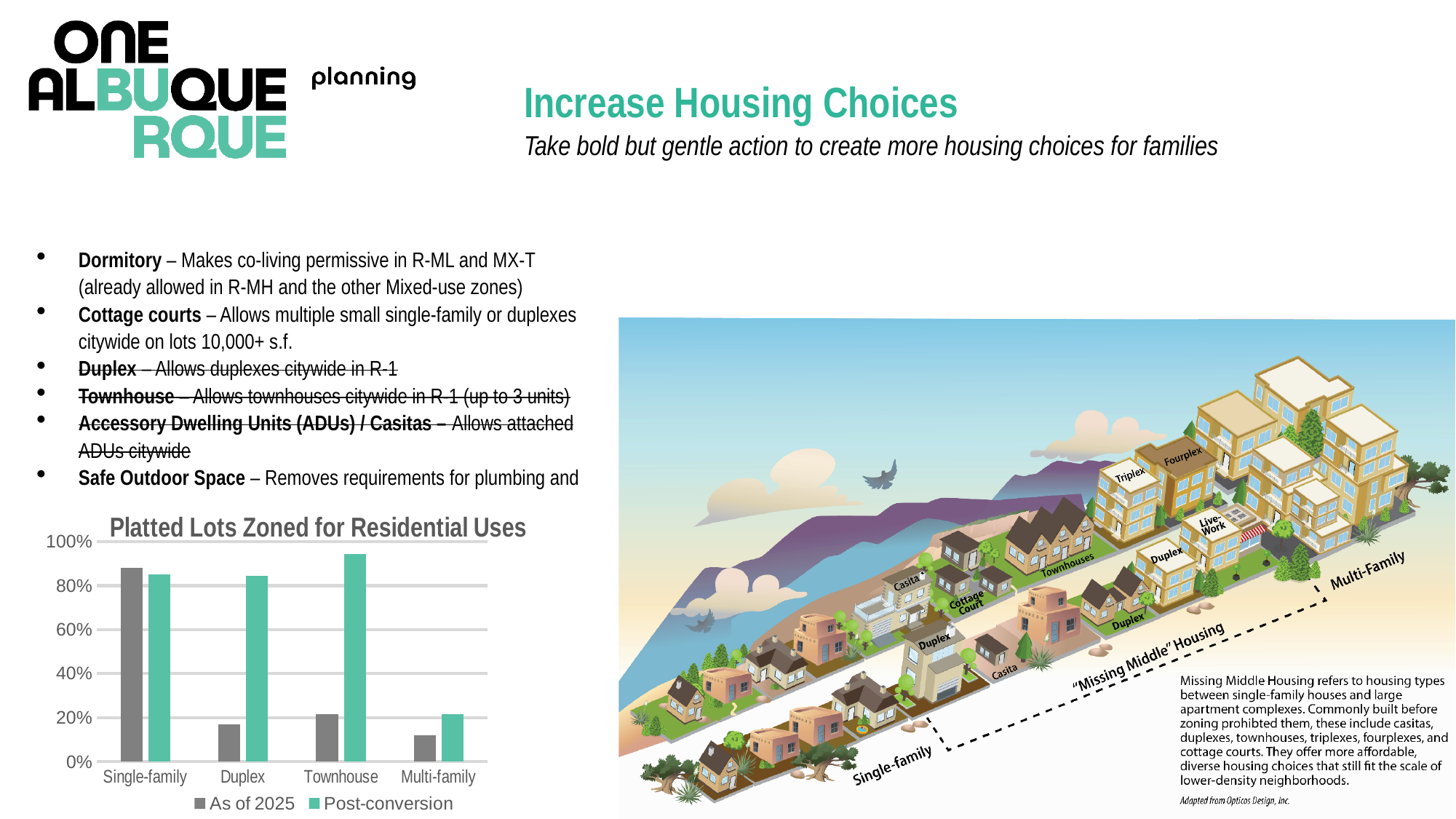
How many categories are shown on the x axis of the "Platted Lots Zoned for Residential Uses" chart? 4 In the "Platted Lots Zoned for Residential Uses" chart, is the "Post-conversion" value for Multi-family greater or less than 40%? less Which category has the lowest "Post-conversion" value in the "Platted Lots Zoned for Residential Uses" chart? Multi-family In the "Platted Lots Zoned for Residential Uses" chart, is the "Post-conversion" value for Townhouse greater or less than 80%? greater Which category has the highest "As of 2025" value in the "Platted Lots Zoned for Residential Uses" chart? Single-family In the "Platted Lots Zoned for Residential Uses" chart, is the "As of 2025" value for Duplex greater or less than 20%? less What are the two series named in the legend of the "Platted Lots Zoned for Residential Uses" chart? As of 2025 and Post-conversion Which category has the lowest "As of 2025" value in the "Platted Lots Zoned for Residential Uses" chart? Multi-family How many series does the legend of the "Platted Lots Zoned for Residential Uses" chart list? 2 What kind of chart is "Platted Lots Zoned for Residential Uses"? bar chart Which category has the highest "Post-conversion" value in the "Platted Lots Zoned for Residential Uses" chart? Townhouse In the "Platted Lots Zoned for Residential Uses" chart, which is larger for Duplex: the "As of 2025" value or the "Post-conversion" value? Post-conversion